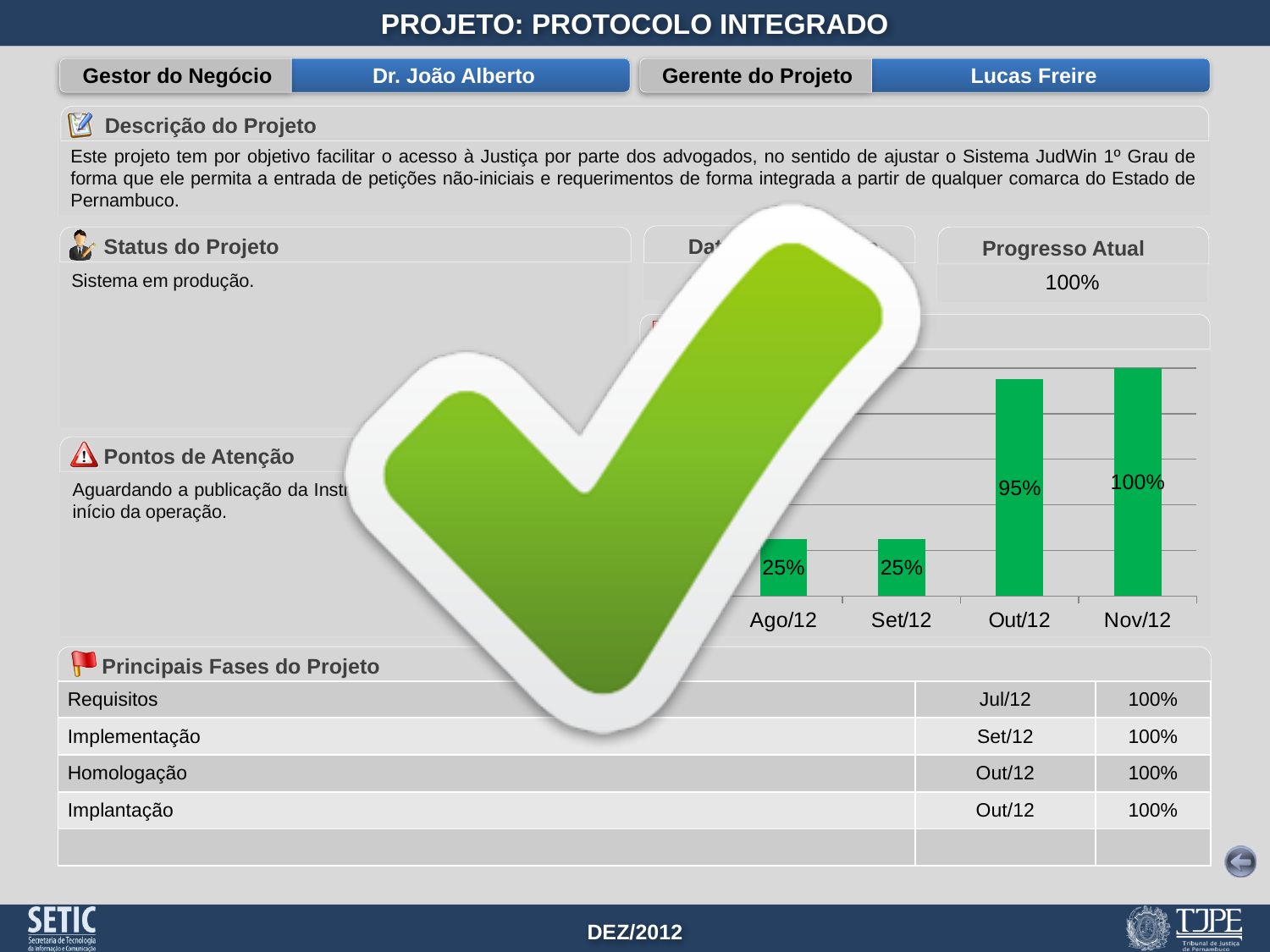
Which month has the highest value in the bar chart? Nov/12 What is the value for Out/12 in the bar chart? 95% What is the value for Set/12 in the bar chart? 25% Which is larger in the bar chart, the value for Out/12 or the value for Set/12? Out/12 What is the value for Nov/12 in the bar chart? 100% What is the difference between the values for Nov/12 and Out/12 in the bar chart? 5% Do the values in the bar chart rise or fall from Ago/12 to Nov/12? rise Are the values for Ago/12 and Set/12 in the bar chart equal? yes What is the difference between the values for Out/12 and Set/12 in the bar chart? 70% What kind of chart is shown on the slide? bar chart What colour are the bars in the chart? green What is the value for Ago/12 in the bar chart? 25%